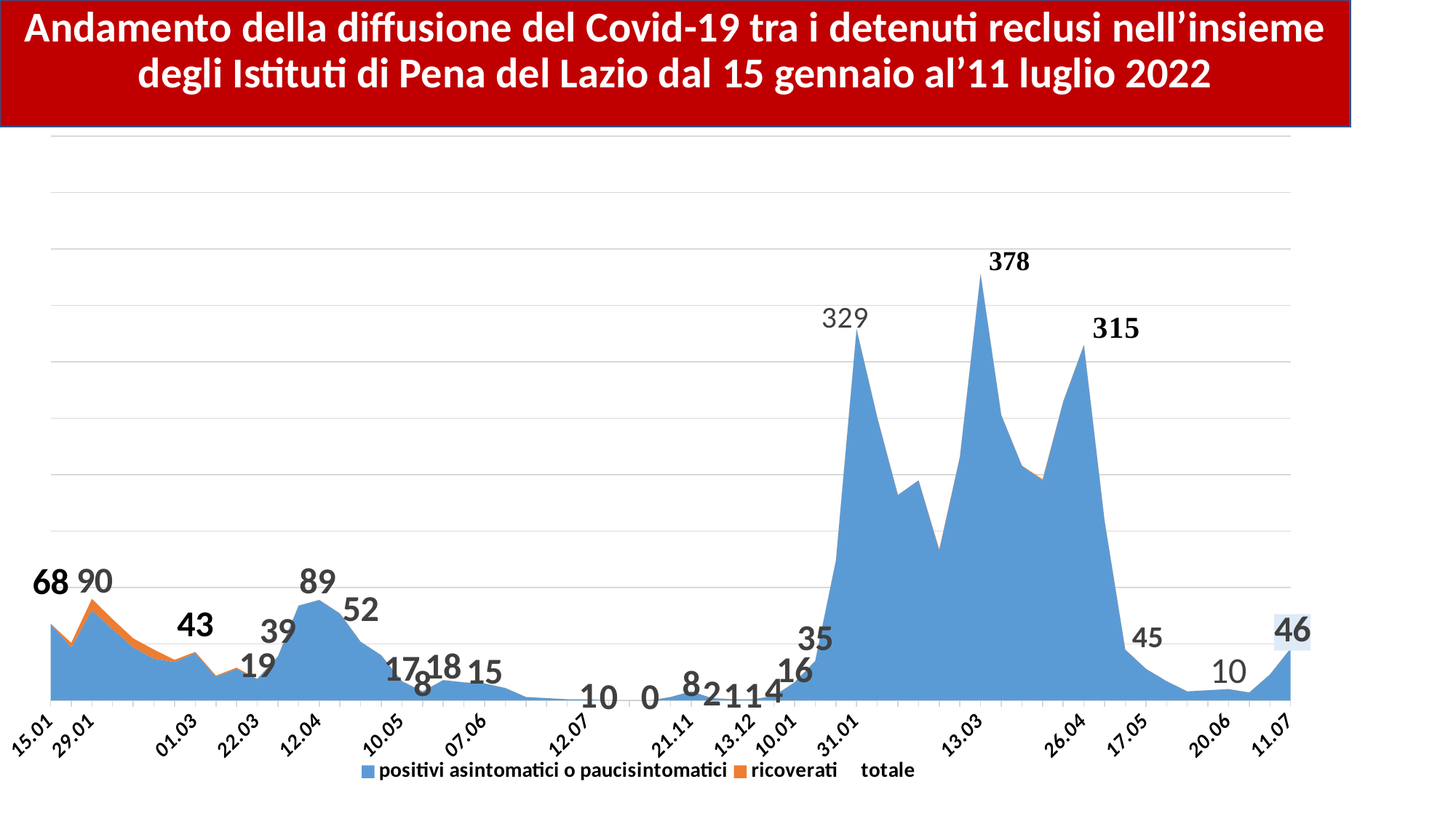
What is the labelled value on 15.01? 68 What is the labelled value on 12.04? 89 What is the labelled value on 31.01? 329 Which colour represents the 'ricoverati' series in the legend? Orange What is the difference between the labelled values on 13.03 and 26.04? 63 What is the highest labelled value on the chart, and on which date does it occur? 378 on 13.03 Which date has the larger labelled value, 31.01 or 26.04? 31.01 What is the labelled value on 26.04? 315 What kind of chart is shown on the slide? Area chart How many series does the legend list? 3 What is the lowest labelled value on the chart? 0 What is the labelled value on 11.07? 46